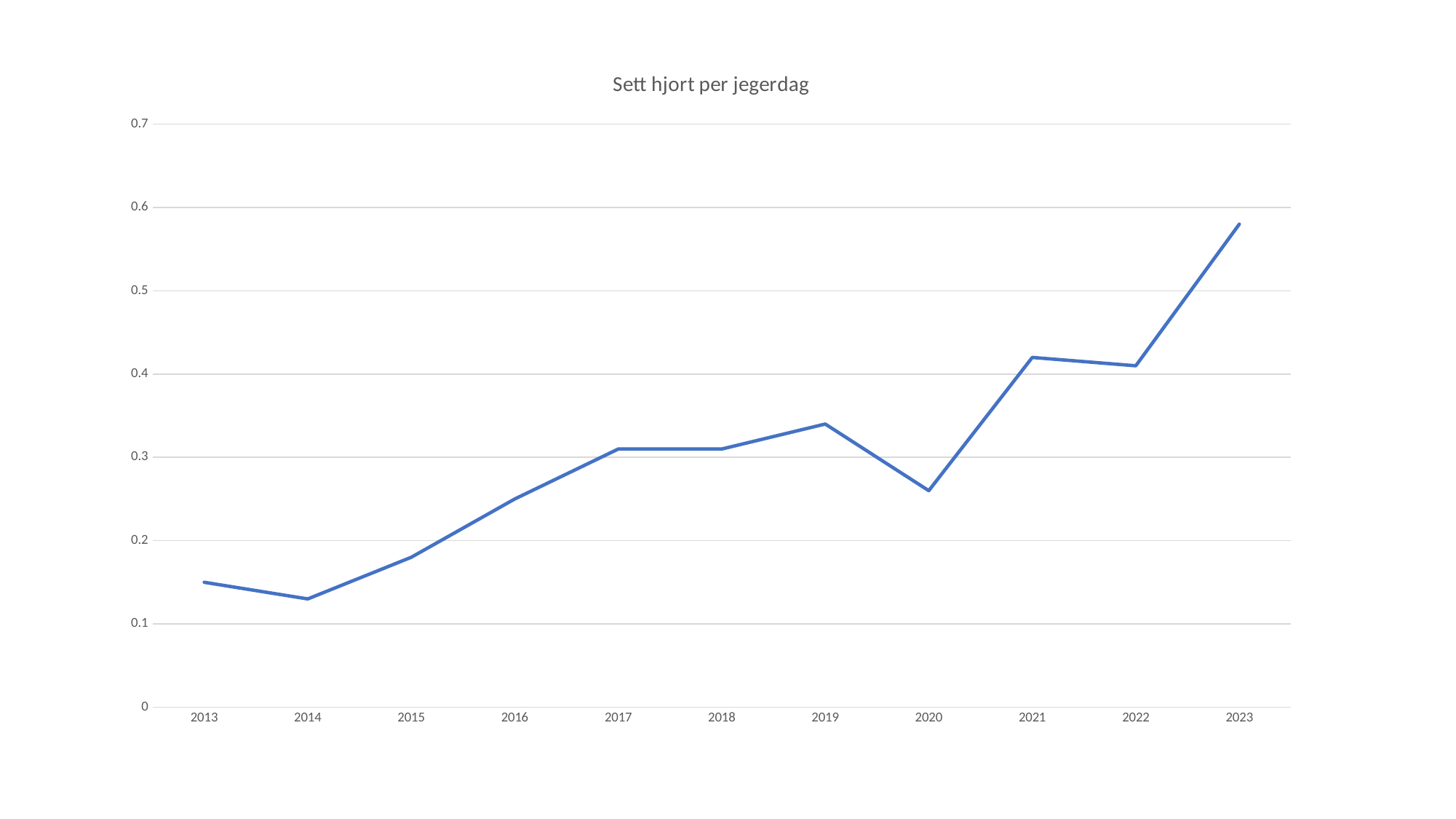
Is the value for 2020 greater or less than 0.3? less Which year has the larger value, 2015 or 2016? 2016 What is the title of the chart? Sett hjort per jegerdag What type of chart is shown on the slide? Line chart How many years are plotted along the x axis? 11 Is the value for 2023 greater or less than 0.5? greater Which year has the highest value? 2023 Is the value for 2013 greater or less than 0.2? less Which year has the lowest value? 2014 Overall, do the values rise or fall from 2013 to 2023? Rise Which year has the larger value, 2020 or 2021? 2021